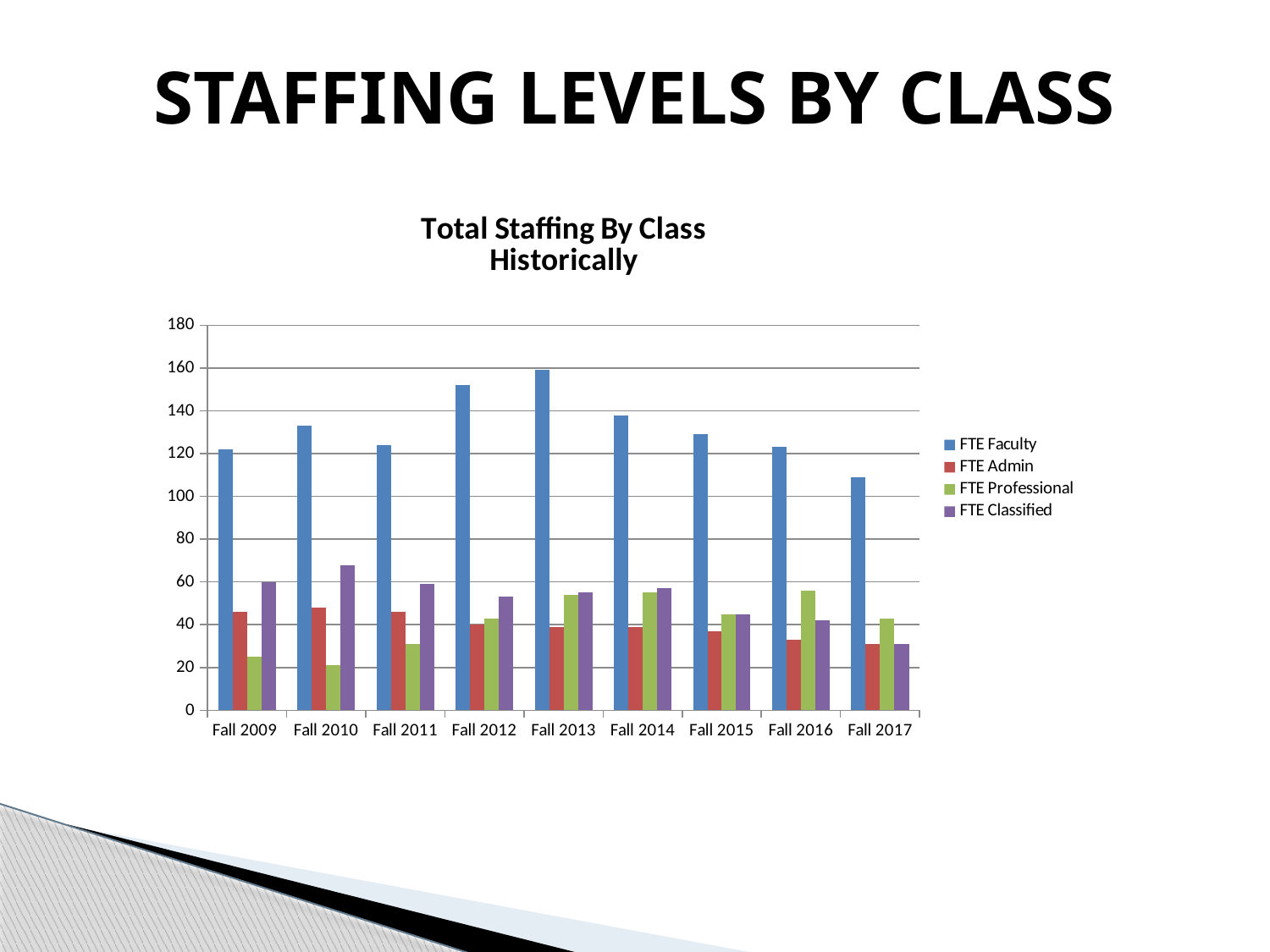
Is the FTE Professional value for Fall 2009 greater or less than 40? less Is the FTE Faculty value for Fall 2013 greater or less than 140? greater What kind of chart is shown on the slide? Bar chart Does FTE Admin generally rise or fall from Fall 2010 to Fall 2017? Fall Is the FTE Faculty value for Fall 2017 greater or less than 120? less In which semester is FTE Faculty lowest? Fall 2017 In which semester is FTE Classified highest? Fall 2010 How many series does the legend list? 4 How many semesters (categories) are shown on the x axis? 9 Which is larger, FTE Faculty in Fall 2012 or FTE Faculty in Fall 2014? Fall 2012 In which semester is FTE Faculty highest? Fall 2013 In which semester is FTE Professional lowest? Fall 2010